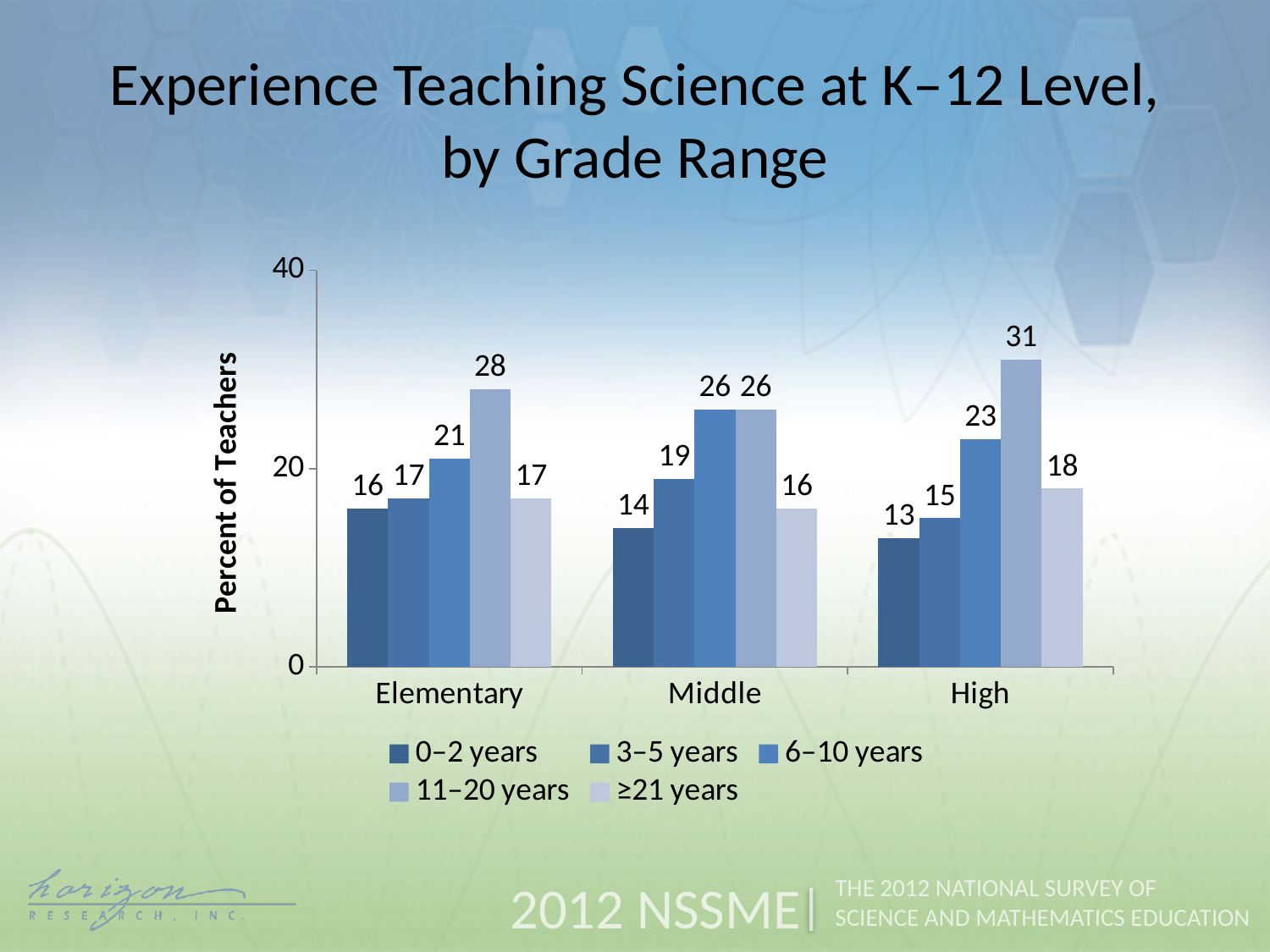
Which grade range has the lowest value for 0–2 years? High What is the label of the vertical axis? Percent of Teachers What is the value for 0–2 years in the Middle grade range? 14 Which is larger: the 6–10 years value for Middle or the 6–10 years value for Elementary? Middle How many grade range categories are shown on the x axis? 3 What kind of chart is shown on the slide? Bar chart What is the value for ≥21 years in the Elementary grade range? 17 How many series does the legend list? 5 What is the value for 11–20 years in the High grade range? 31 Is the value for 11–20 years in the Elementary grade range greater or less than 20? greater What is the difference between the 11–20 years value and the 0–2 years value in the High grade range? 18 Which grade range has the highest value for 11–20 years? High